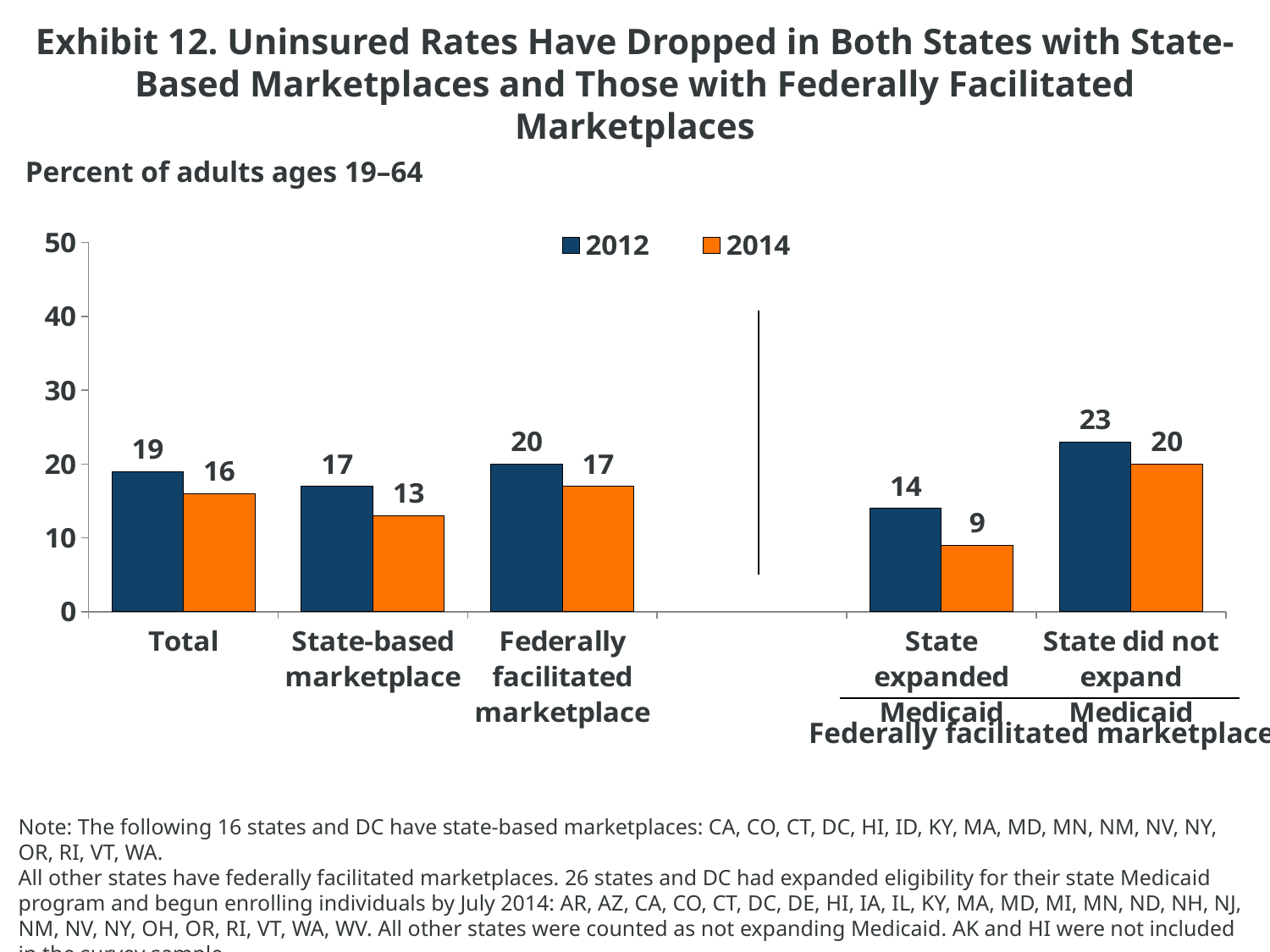
By how many points did the uninsured rate for State-based marketplace drop from 2012 to 2014? 4 Which category had the lowest uninsured rate in 2014? State expanded Medicaid What is the difference between the 2014 uninsured rates for states that did not expand Medicaid and states that expanded Medicaid? 11 Which is larger: the 2014 uninsured rate for Federally facilitated marketplace or for State-based marketplace? Federally facilitated marketplace What was the uninsured rate for Total in 2012? 19 What was the uninsured rate in 2014 for states that expanded Medicaid? 9 Which category had the highest uninsured rate in 2012? State did not expand Medicaid Which colour represents 2014 in the chart? Orange How many series does the legend list? 2 What was the uninsured rate for State-based marketplace in 2014? 13 What was the uninsured rate in 2012 for states that did not expand Medicaid? 23 What kind of chart is shown on the slide? Bar chart